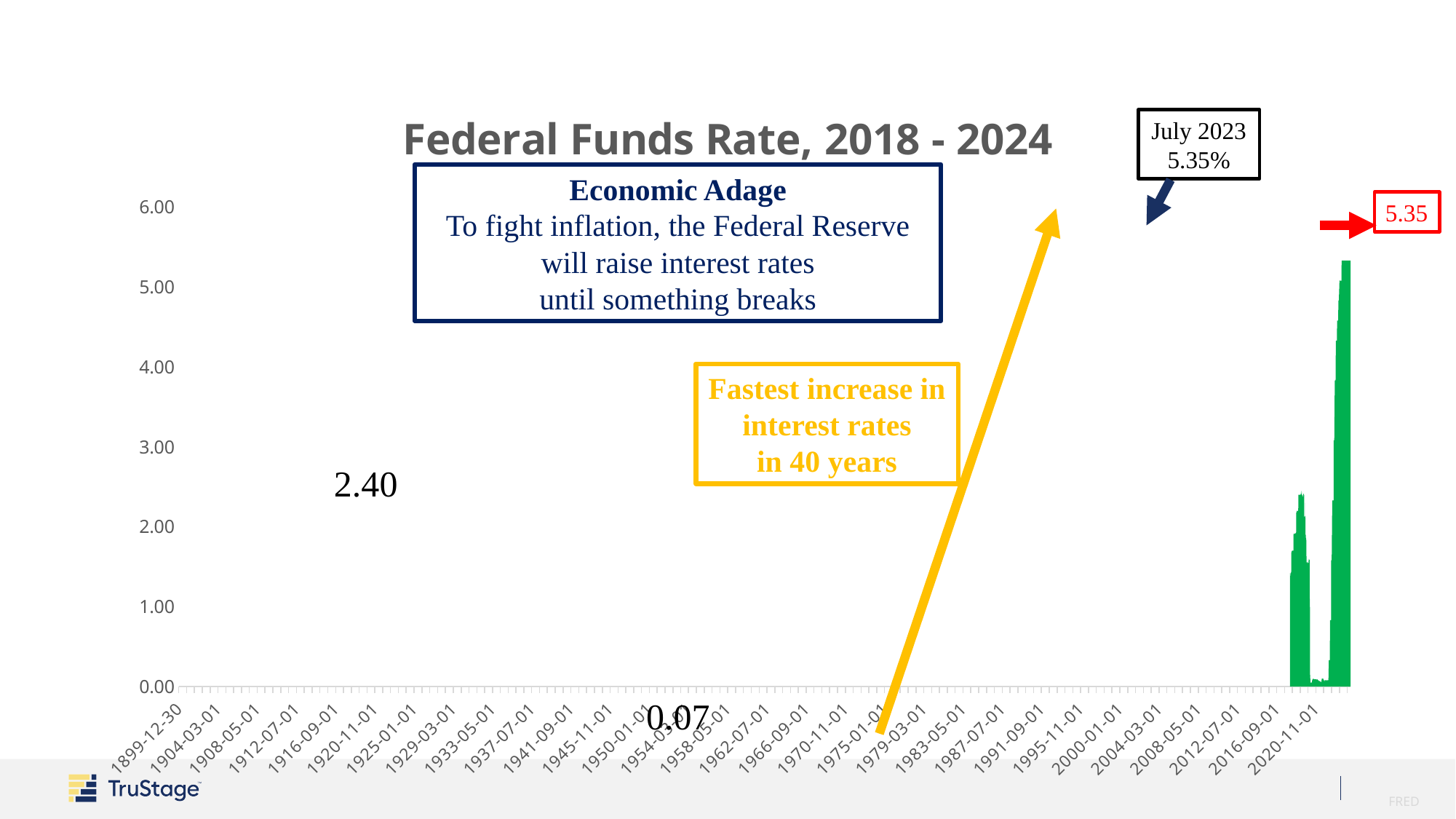
Does the Federal Funds Rate rise or fall between the labelled low of 0.07 and the labelled value of 5.35? rise What is the difference between the labelled peak of 5.35 and the labelled low of 0.07? 5.28 According to the annotation, in which month and year did the Federal Funds Rate reach 5.35%? July 2023 What is the difference between the labelled values 5.35 and 2.40? 2.95 Is the most recent peak of the Federal Funds Rate greater or less than 5.00? greater Is the earlier peak of the Federal Funds Rate (labelled 2.40) greater or less than 2.00? greater What is the highest tick value shown on the y axis? 6.00 Which labelled value is larger, 2.40 or 5.35? 5.35 What is the highest value labelled on the chart? 5.35 What is the title of the chart? Federal Funds Rate, 2018 - 2024 What is the lowest value labelled on the chart? 0.07 What kind of chart is shown on the slide? line chart